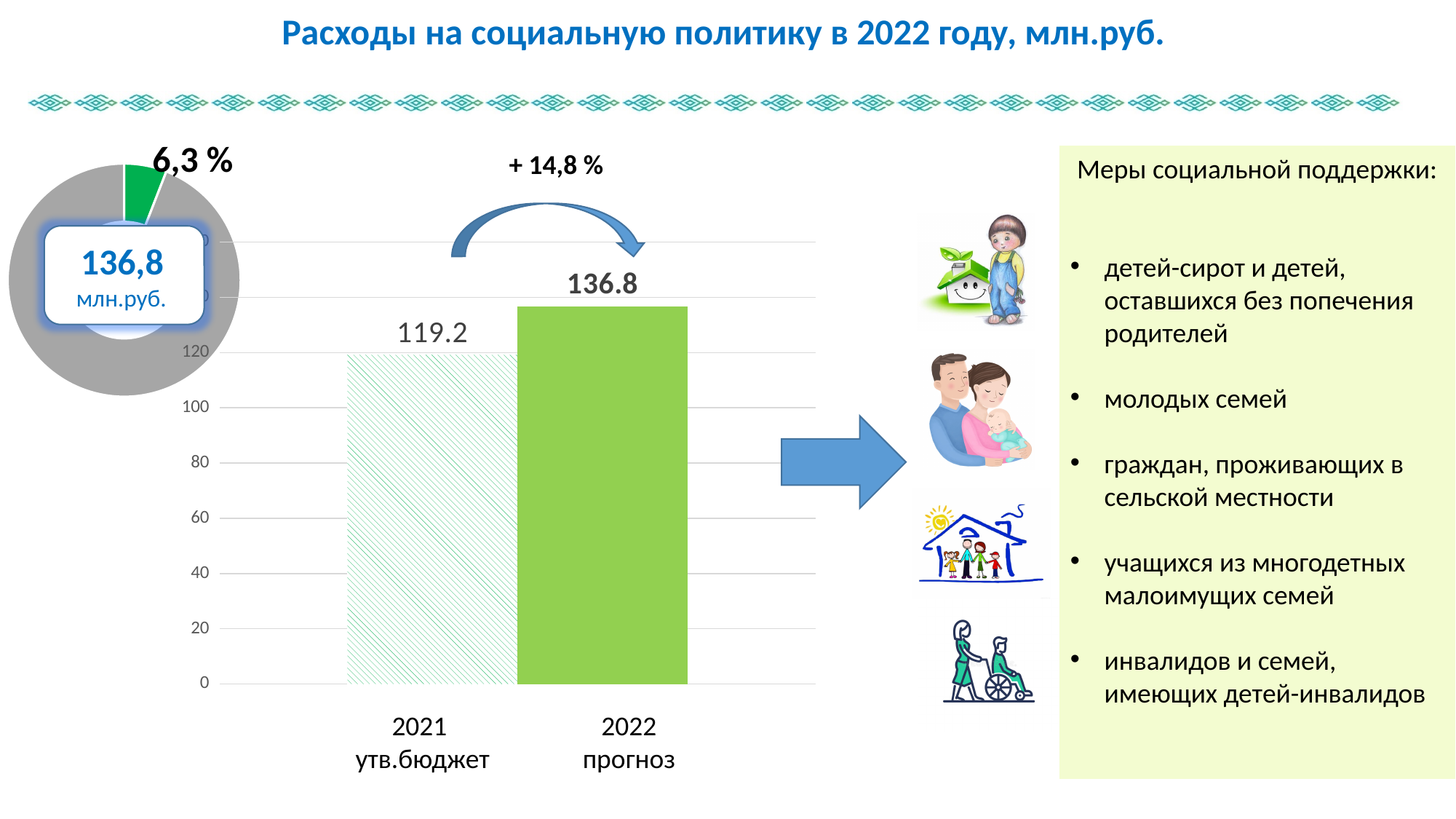
In the bar chart, is the value for 2021 утв.бюджет greater or less than 100? greater In the bar chart, what is the difference between the 2022 прогноз value and the 2021 утв.бюджет value? 17.6 How many bars are in the bar chart? 2 What kind of chart is the chart in the middle of the slide with the years 2021 and 2022? bar chart In the bar chart, what is the value for 2021 утв.бюджет? 119.2 In the bar chart, which category has the lowest value? 2021 утв.бюджет In the circular chart on the left of the slide, what percentage share is shown by the green slice? 6,3 % In the bar chart, what is the value for 2022 прогноз? 136.8 What percentage change is printed above the arrow in the bar chart? + 14,8 % In the bar chart, which is larger: the value for 2021 утв.бюджет or the value for 2022 прогноз? 2022 прогноз In the bar chart, do the values rise or fall from 2021 to 2022? rise In the bar chart, which category has the highest value? 2022 прогноз